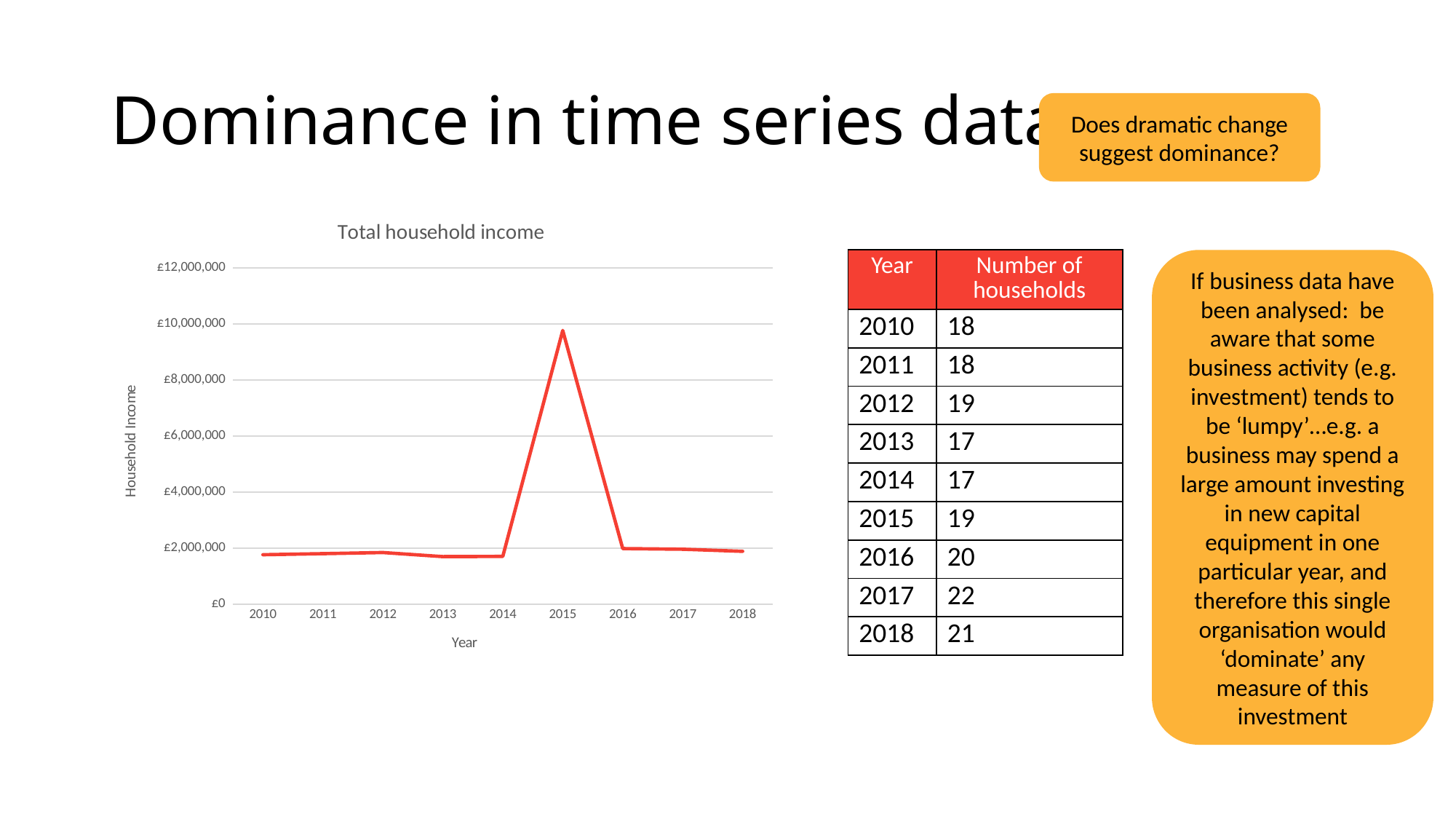
Which year has the highest total household income in the chart? 2015 How many years are plotted on the x axis of the chart? 9 Is the value for 2015 greater or less than £8,000,000? greater Does the line rise or fall between 2014 and 2015? rise What is the title of the chart? Total household income What is the label on the vertical axis of the chart? Household Income Is the value for 2013 greater or less than £2,000,000? less Does the line rise or fall between 2015 and 2016? fall Which year has the larger total household income, 2014 or 2015? 2015 What kind of chart is shown on the slide? line chart Is the value for 2015 greater or less than £10,000,000? less